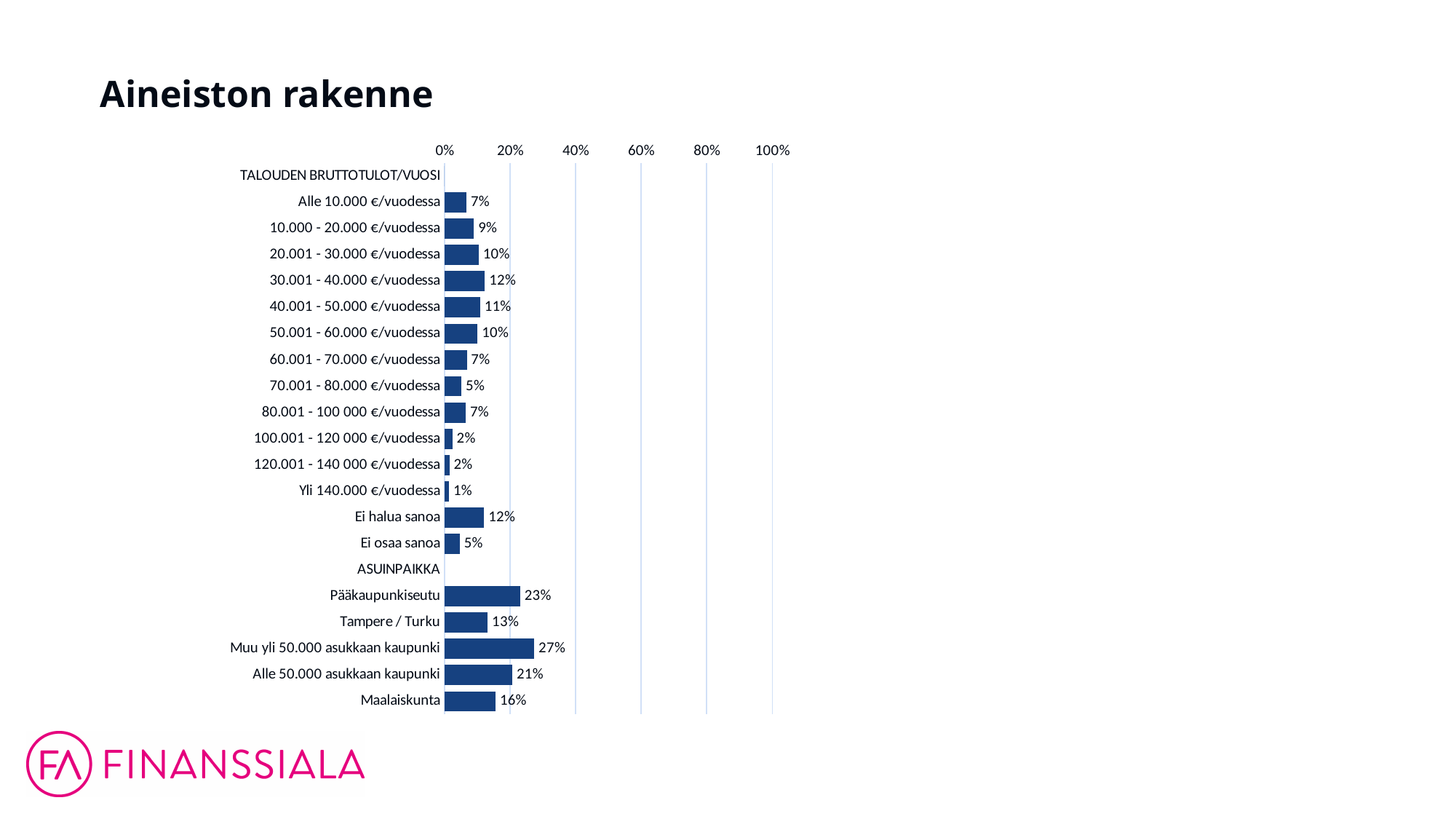
Which category has the lowest value on the chart? Yli 140.000 €/vuodessa What is the value for Pääkaupunkiseutu? 23% What is the title of the slide? Aineiston rakenne How many categories are listed under the ASUINPAIKKA section? 5 Is the value for Pääkaupunkiseutu greater or less than 20%? greater What is the value for Maalaiskunta? 16% Which category has the highest value on the chart? Muu yli 50.000 asukkaan kaupunki Which is larger, the value for Alle 50.000 asukkaan kaupunki or the value for Maalaiskunta? Alle 50.000 asukkaan kaupunki What is the value for Yli 140.000 €/vuodessa? 1% What is the difference between the values for Muu yli 50.000 asukkaan kaupunki and Tampere / Turku? 14% What is the value for 30.001 - 40.000 €/vuodessa? 12% What kind of chart is shown on the slide? Bar chart